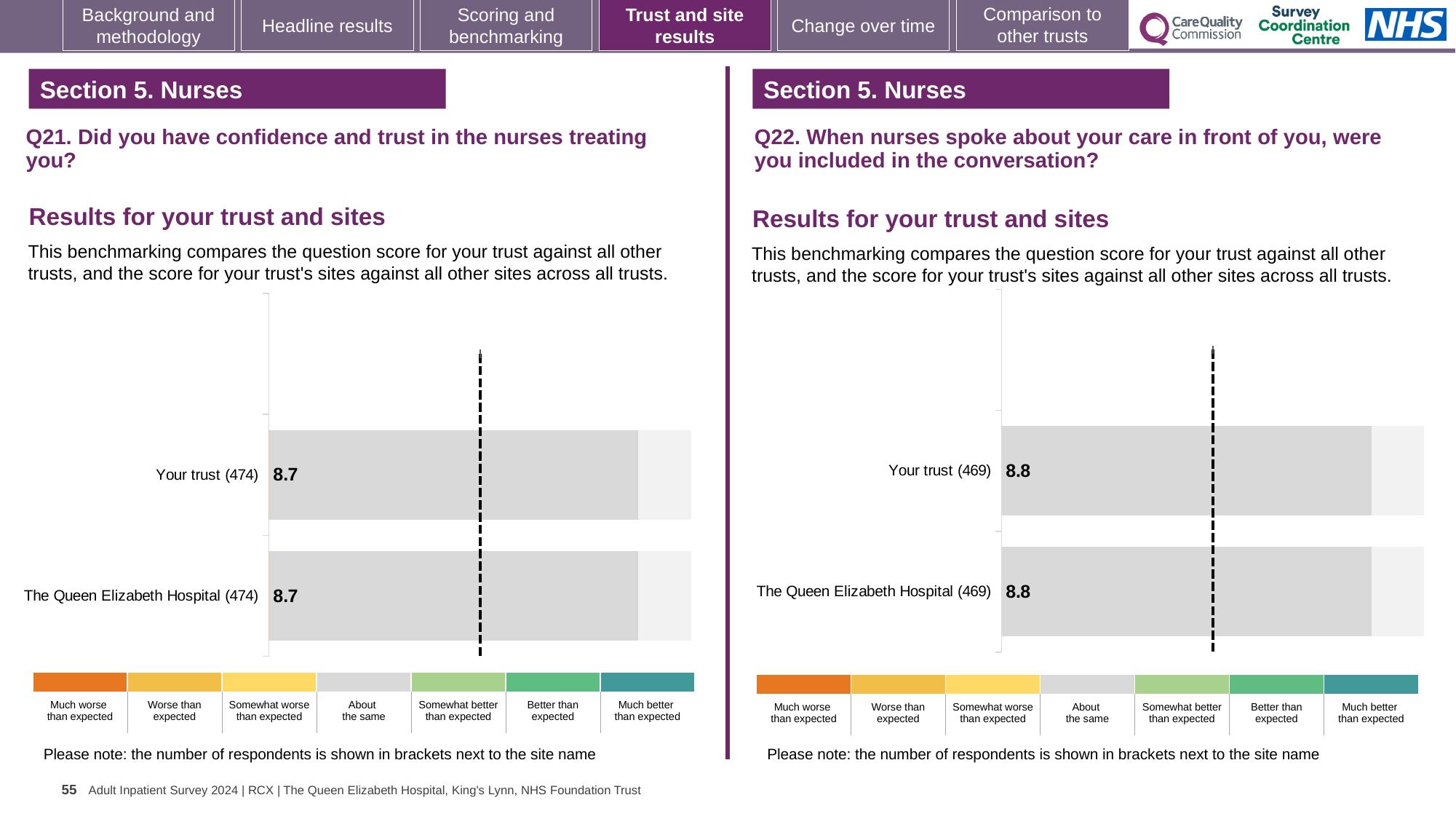
In the Q21 chart on the left, what is the score for Your trust? 8.7 In the Q21 chart on the left, how many bars are plotted? 2 In the Q22 chart on the right, what is the score for Your trust? 8.8 In the Q21 chart on the left, what is the score for The Queen Elizabeth Hospital? 8.7 In the Q22 chart on the right, what is the difference between the score for Your trust and the score for The Queen Elizabeth Hospital? 0 In the Q22 chart on the right, how many bars are plotted? 2 In the Q22 chart on the right, what is the score for The Queen Elizabeth Hospital? 8.8 In the Q22 chart on the right, how many respondents are shown in brackets next to The Queen Elizabeth Hospital? 469 In the Q21 chart on the left, how many respondents are shown in brackets next to Your trust? 474 Is the Your trust score in the Q22 chart on the right larger or smaller than the Your trust score in the Q21 chart on the left? Larger In the Q21 chart on the left, what is the difference between the score for Your trust and the score for The Queen Elizabeth Hospital? 0 What kind of chart is the Q21 chart on the left? Bar chart